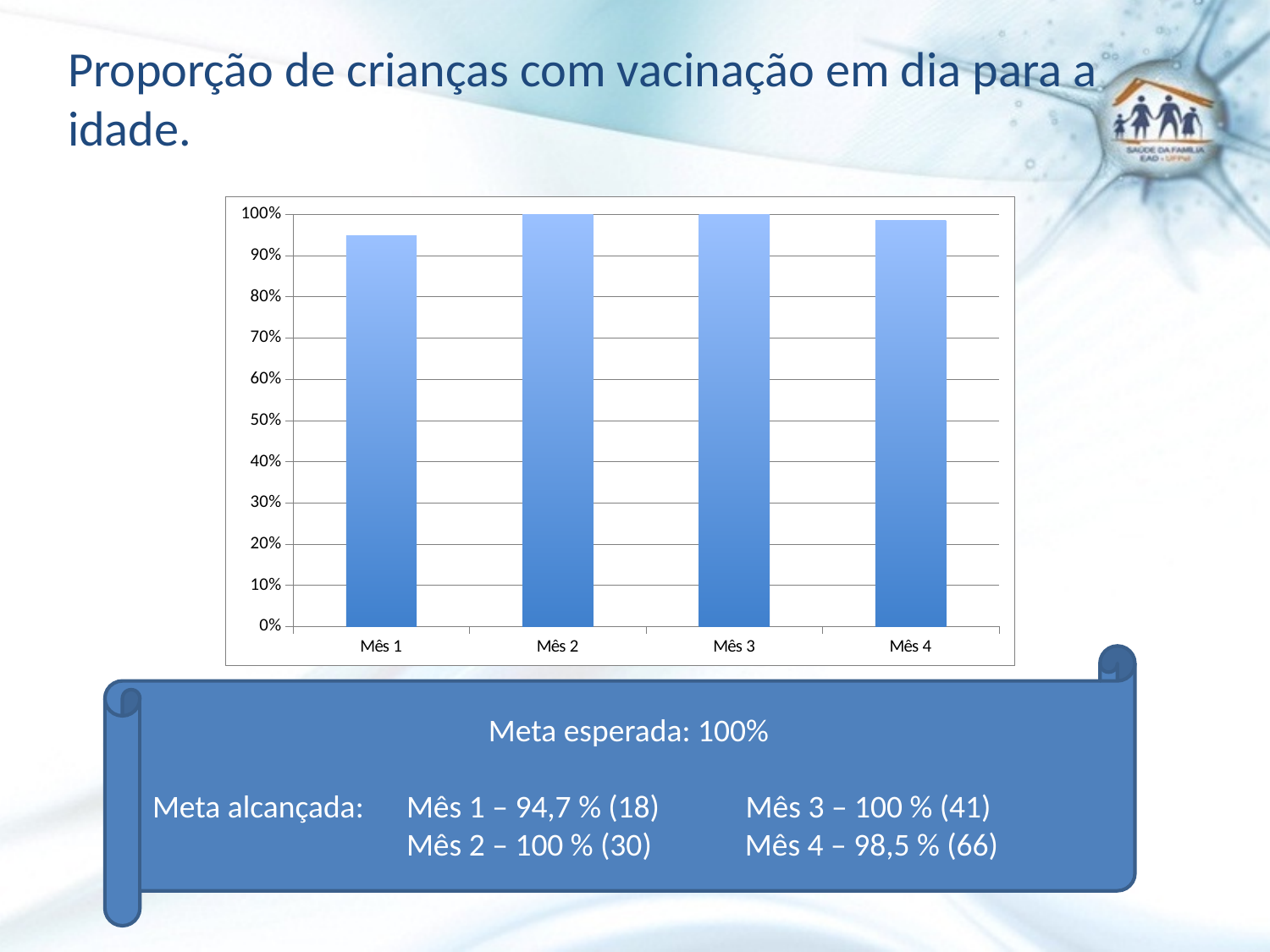
What is the expected target (meta esperada) stated on the slide? 100% What value does the chart show for Mês 2? 100% What value does the chart show for Mês 3? 100% According to the slide, what proportion was reached in Mês 1? 94,7 % How many months (categories) are plotted on the x axis of the chart? 4 Which is larger, the value for Mês 1 or the value for Mês 4? Mês 4 What is the difference in percentage points between Mês 2 and Mês 1? 5,3 Which month has the lowest bar in the chart? Mês 1 Is the value for Mês 1 greater or less than 90%? greater According to the slide, what proportion was reached in Mês 4? 98,5 % What kind of chart is shown on the slide? Bar chart What is the title of the slide containing the chart? Proporção de crianças com vacinação em dia para a idade.